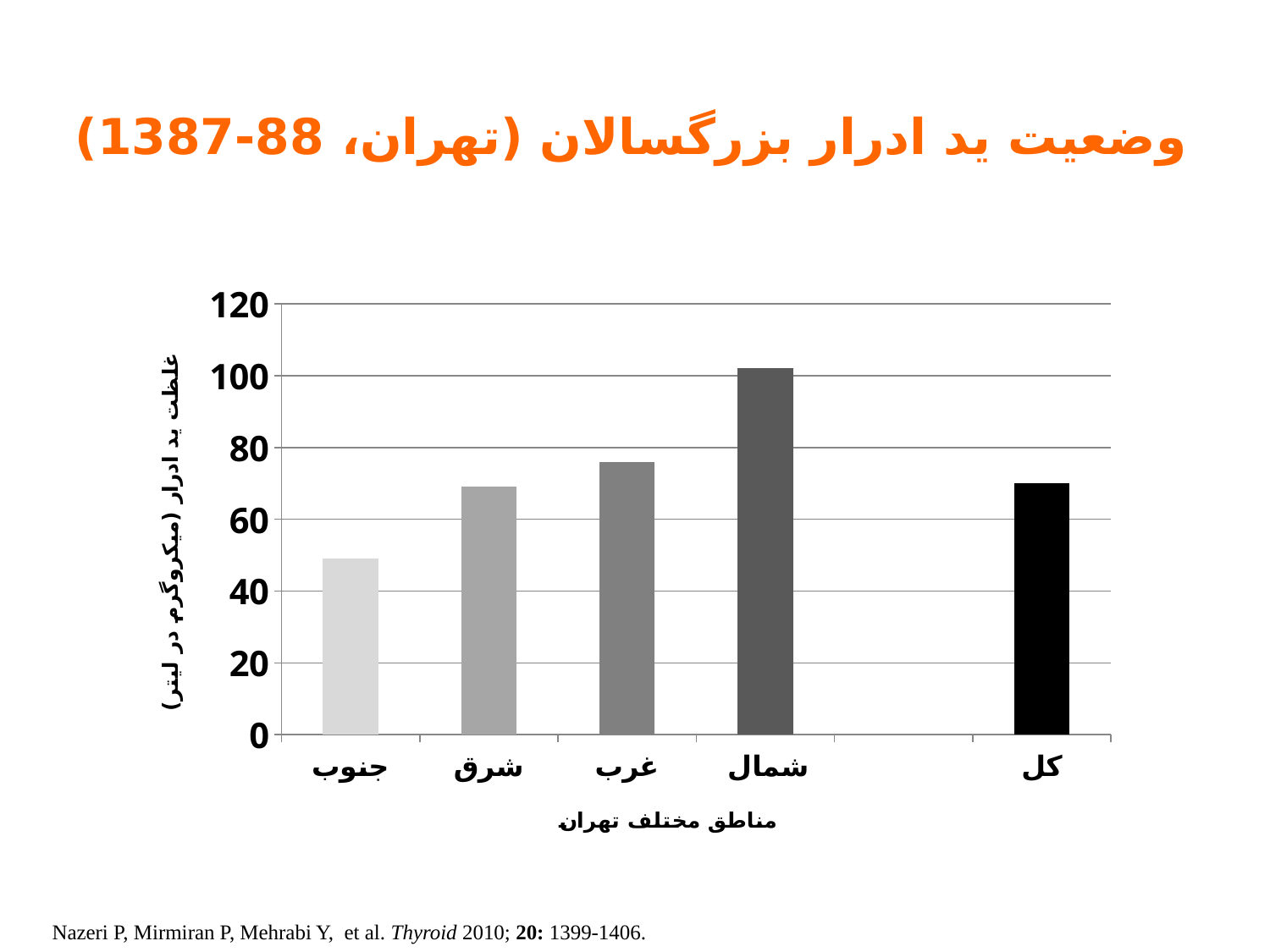
Is the value for غرب greater or less than 80? less How many bars (categories) are plotted in the chart? 5 Which category has the lowest bar in the chart? جنوب What is the title of the x axis of the chart? مناطق مختلف تهران Is the value for کل greater or less than 60? greater Is the value for جنوب greater or less than 60? less Which has the larger value, غرب or شرق? غرب Which has the larger value, شمال or جنوب? شمال Which category has the highest bar in the chart? شمال What kind of chart is shown on the slide? bar chart